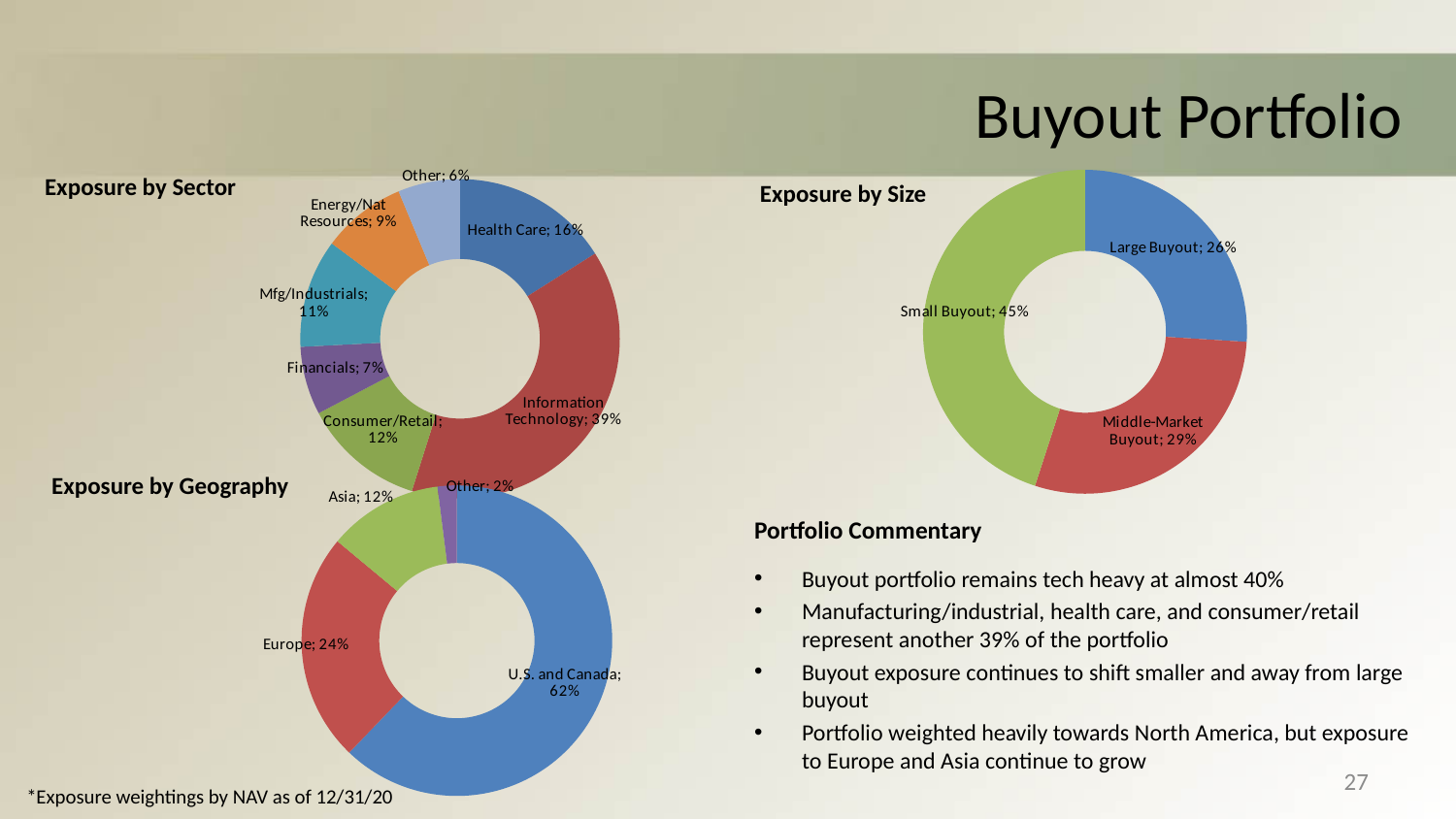
In the Exposure by Size chart, what is the share for Small Buyout? 45% In the Exposure by Sector chart, what is the share for Information Technology? 39% In the Exposure by Sector chart, how many sectors are shown? 7 In the Exposure by Geography chart, what is the share for Europe? 24% In the Exposure by Geography chart, how many regions are shown? 4 In the Exposure by Sector chart, which is larger, Mfg/Industrials or Energy/Nat Resources? Mfg/Industrials In the Exposure by Sector chart, which sector has the smallest share? Other In the Exposure by Size chart, what is the difference between Middle-Market Buyout and Large Buyout? 3% What kind of chart is the Exposure by Size chart? Doughnut (pie) chart In the Exposure by Geography chart, which region has the largest share? U.S. and Canada In the Exposure by Size chart, which category has the largest share? Small Buyout In the Exposure by Sector chart, what is the difference between the Health Care and Financials shares? 9%